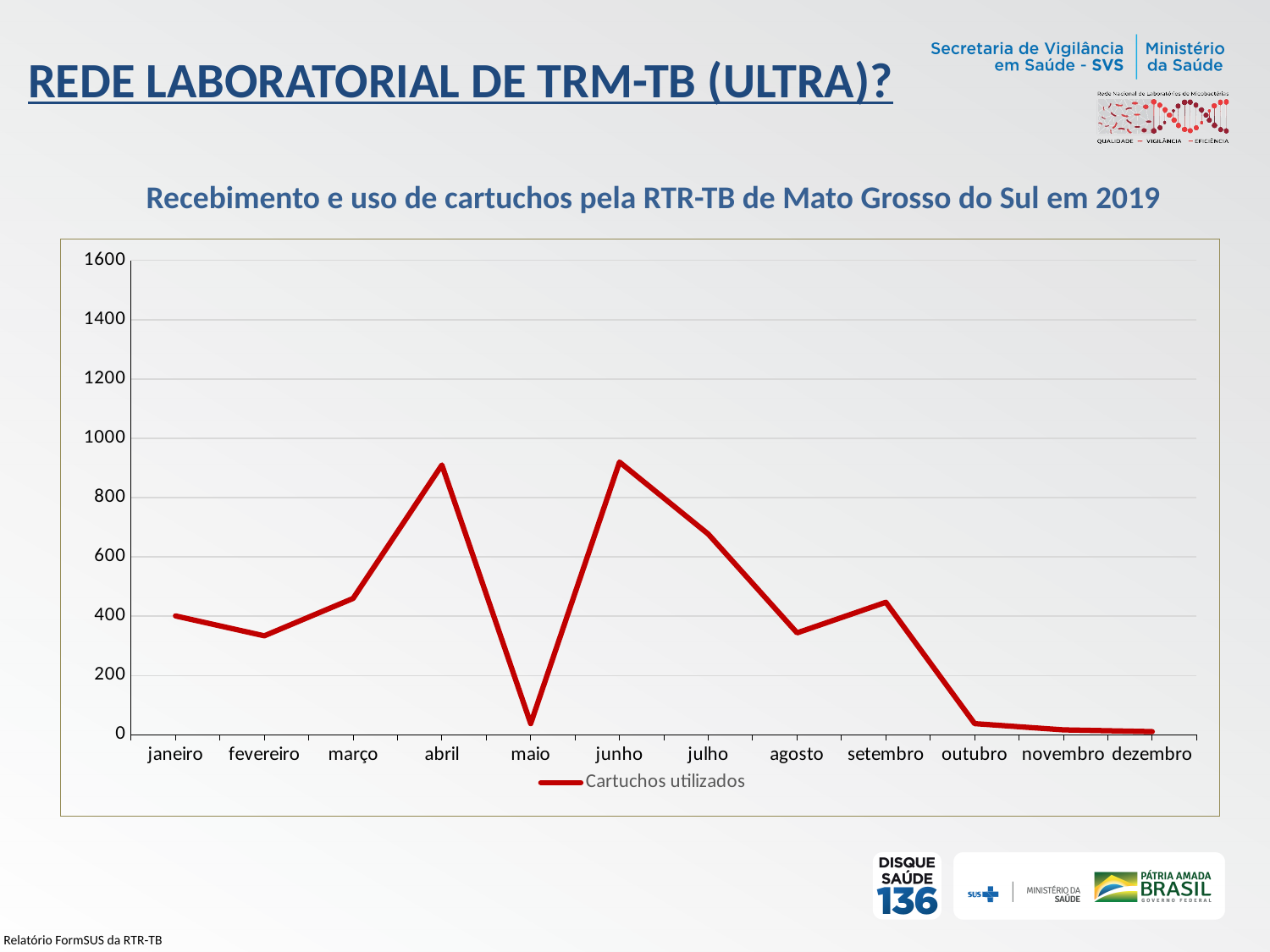
Which month has the larger value, abril or maio? abril Is the value for maio greater or less than 200? less Is the value for abril greater or less than 800? greater What is the title of the chart? Recebimento e uso de cartuchos pela RTR-TB de Mato Grosso do Sul em 2019 Is the value for julho greater or less than 600? greater What kind of chart is shown on the slide? line chart How many months are plotted along the x axis of the chart? 12 How many series does the chart legend list? 1 Which month has the larger value, junho or agosto? junho Do the values rise or fall from setembro to dezembro? fall What is the name of the series shown in the chart legend? Cartuchos utilizados